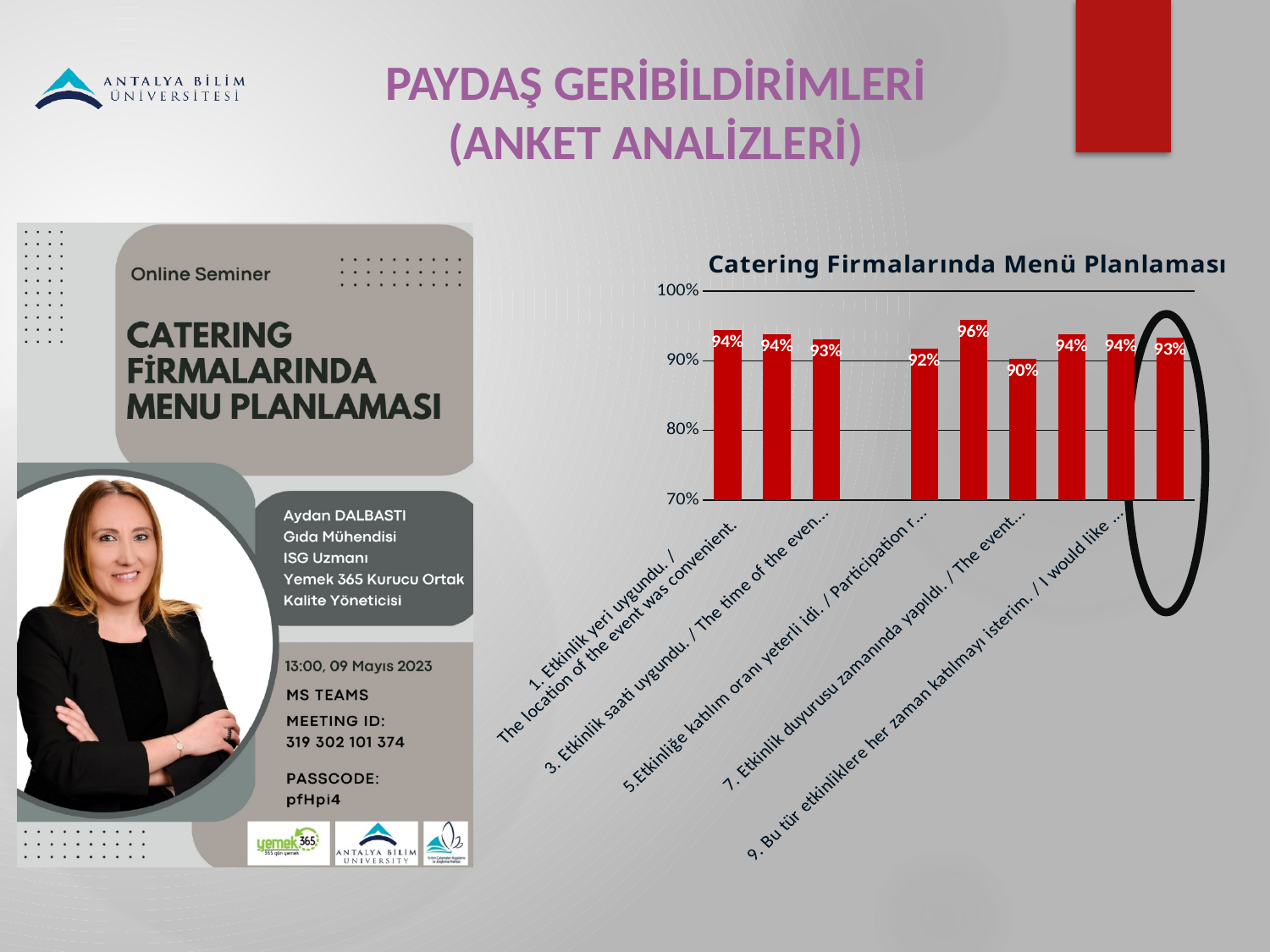
Is the value for category 7 ('Etkinlik duyurusu zamanında yapıldı') greater or less than 80%? greater What is the highest value shown in the chart? 96% What is the value for the category '3. Etkinlik saati uygundu. / The time of the even...'? 93% What is the difference between the highest value (96%) and the lowest value (90%) in the chart? 6 percentage points What is the value for the category '7. Etkinlik duyurusu zamanında yapıldı. / The event...'? 90% What is the value of the last bar, the one circled in black? 93% What kind of chart is shown on the slide? bar chart What is the value for the first category, '1. Etkinlik yeri uygundu. / The location of the event was convenient.'? 94% What is the lowest value shown in the chart? 90% What is the value for the category '5.Etkinliğe katılım oranı yeterli idi. / Participation r...'? 92% What is the title of the chart on the slide? Catering Firmalarında Menü Planlaması Which is larger: the value for category 1 (location of the event) or the value for category 7 (event announcement)? category 1 (94%)